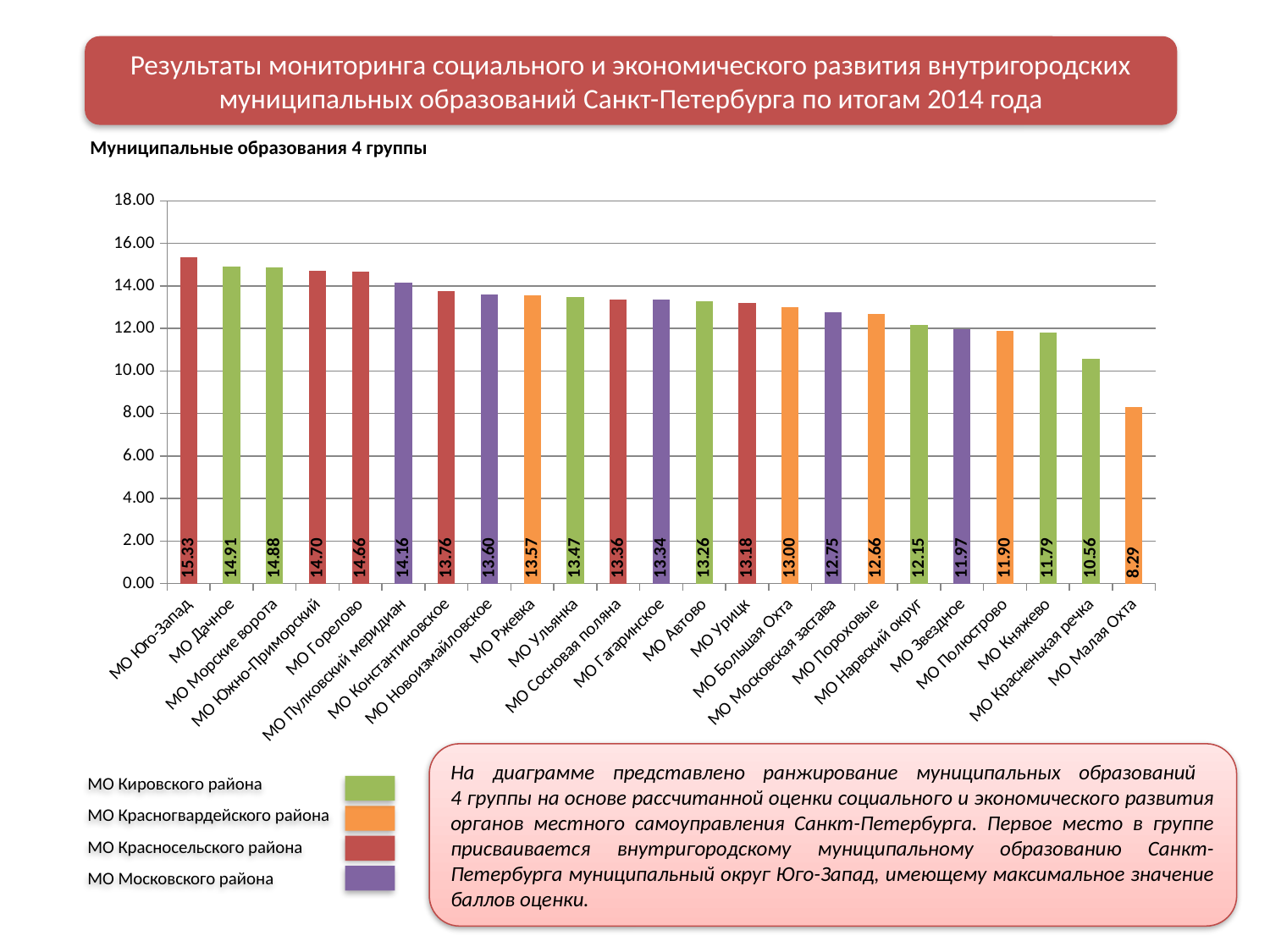
What is the value for МО Большая Охта? 13.00 Which has a larger value, МО Дачное or МО Горелово? МО Дачное Which municipality has the lowest value on the chart? МО Малая Охта Do the values rise or fall from left to right along the x axis? fall What is the value for МО Пулковский меридиан? 14.16 How many municipalities are shown on the chart? 23 Is the value for МО Звездное greater or less than 12.00? less What is the difference between the values for МО Юго-Запад and МО Малая Охта? 7.04 What kind of chart is shown on the slide? bar chart What is the value for МО Красненькая речка? 10.56 Which municipality has the highest value on the chart? МО Юго-Запад What is the value for МО Юго-Запад? 15.33